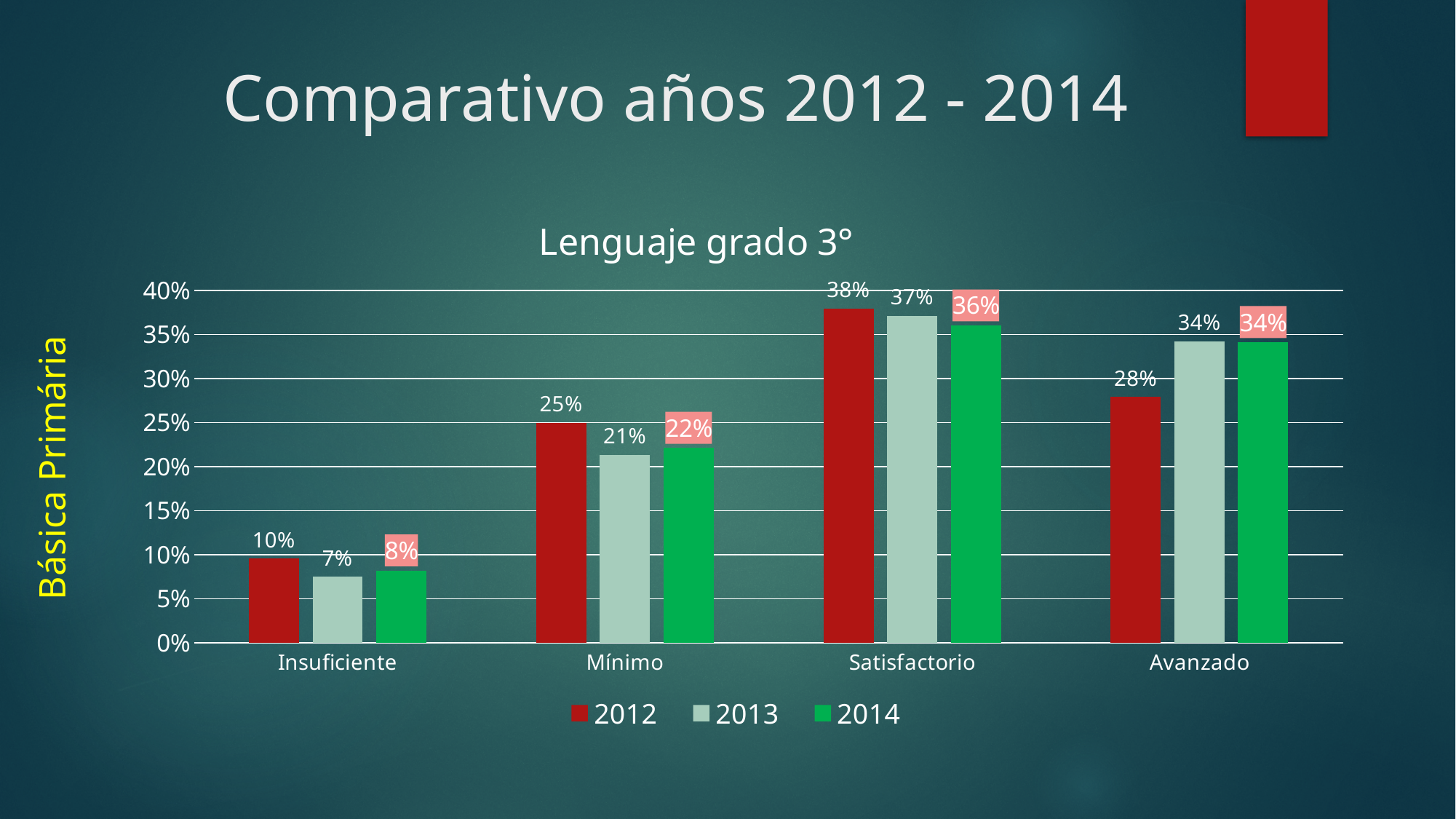
What is the title of the chart? Lenguaje grado 3° What is the value for 2012 in the Satisfactorio category? 38% What is the difference between the 2012 and 2014 values in the Avanzado category? 6% How many series does the legend list? 3 Which category has the highest value for the 2012 series? Satisfactorio How many categories are shown on the x axis? 4 Which category has the lowest value for the 2014 series? Insuficiente What kind of chart is shown on the slide? Bar chart What is the difference between the 2012 and 2013 values in the Mínimo category? 4% What is the value for 2014 in the Mínimo category? 22% Which is larger in the Insuficiente category, the 2012 value or the 2014 value? 2012 What is the value for 2013 in the Insuficiente category? 7%